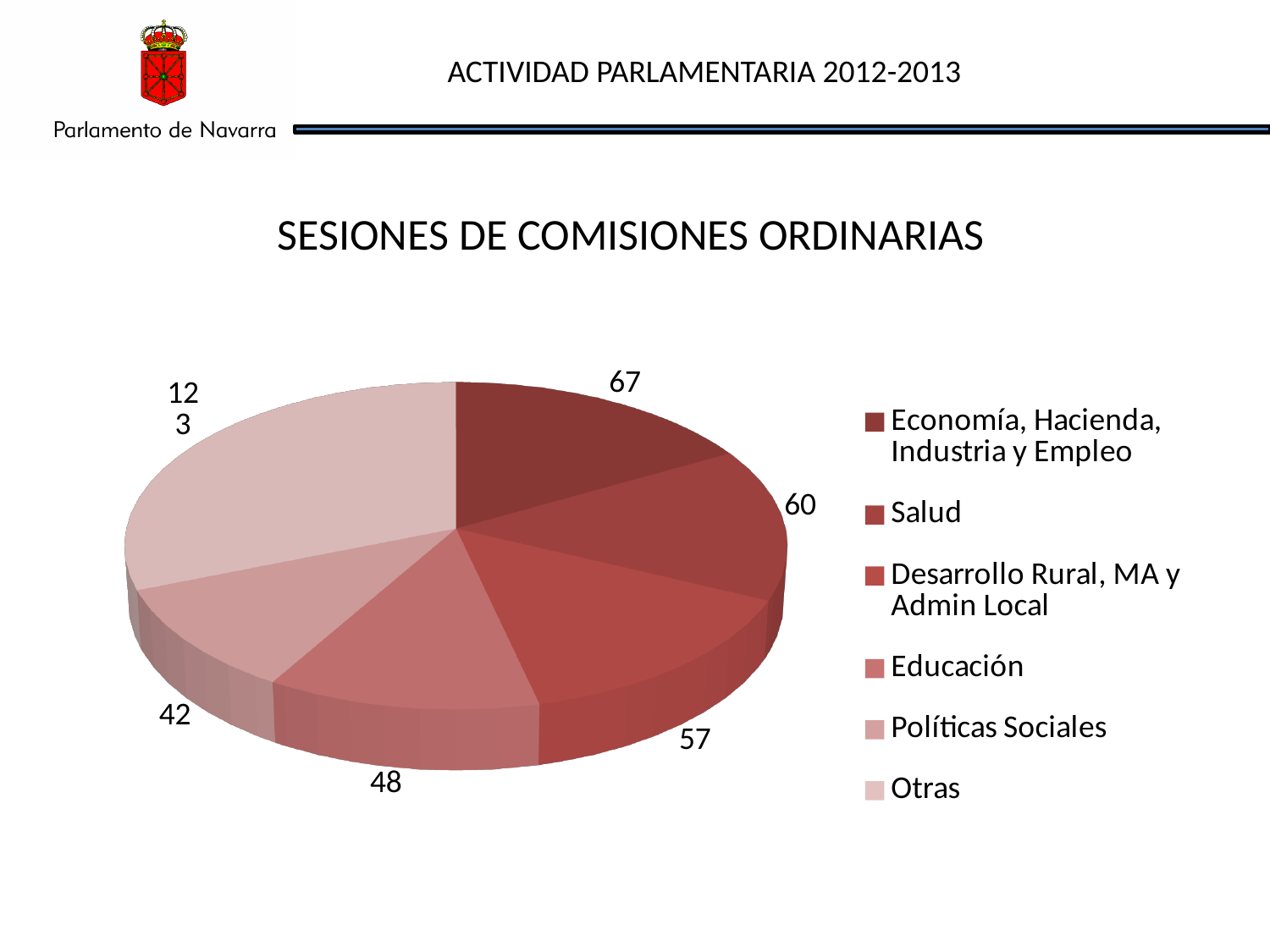
What is the difference between the values for Educación and Políticas Sociales? 6 What value is shown for Desarrollo Rural, MA y Admin Local? 57 How many entries does the legend list? 6 Which has a larger value, Salud or Desarrollo Rural, MA y Admin Local? Salud What value is shown for Educación? 48 What is the title of the chart? SESIONES DE COMISIONES ORDINARIAS What kind of chart is shown on the slide? Pie chart Which has a larger value, Educación or Políticas Sociales? Educación How many sessions are shown for Economía, Hacienda, Industria y Empleo? 67 What value is shown for Políticas Sociales? 42 What is the difference between the values for Economía, Hacienda, Industria y Empleo and Salud? 7 What value is shown for Salud? 60